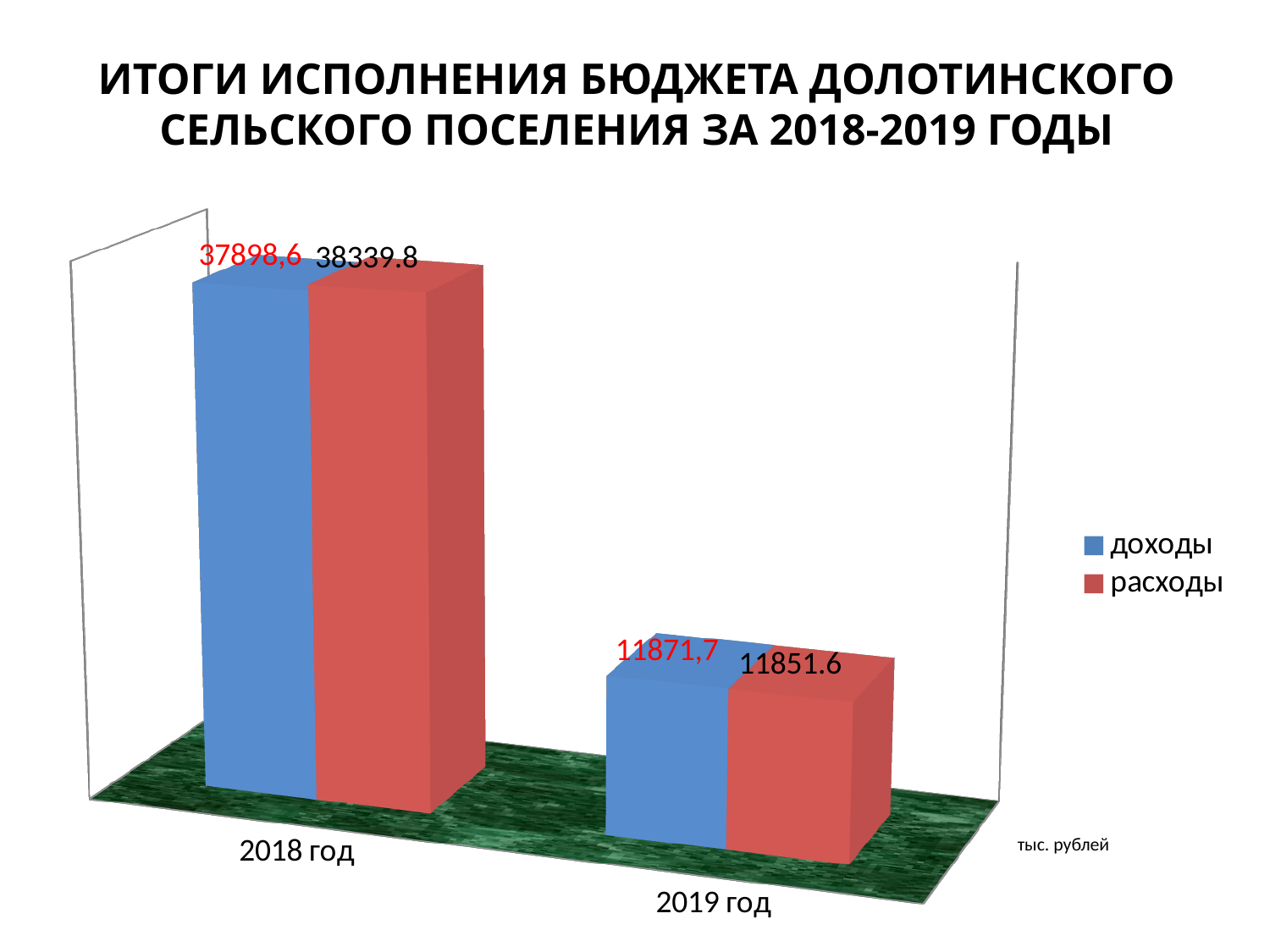
Which year has the lower value for расходы? 2019 год What is the value of доходы for 2018 год? 37898,6 Is the value for доходы in 2018 год larger or smaller than the value for доходы in 2019 год? larger What kind of chart is shown on the slide? bar chart What is the difference between расходы and доходы for 2018 год? 441.2 How many year categories are shown on the x axis? 2 What is the value of доходы for 2019 год? 11871,7 What is the value of расходы for 2018 год? 38339.8 What is the value of расходы for 2019 год? 11851.6 Which year has the higher value for доходы? 2018 год How many series does the legend list? 2 Which colour represents расходы in the legend? red